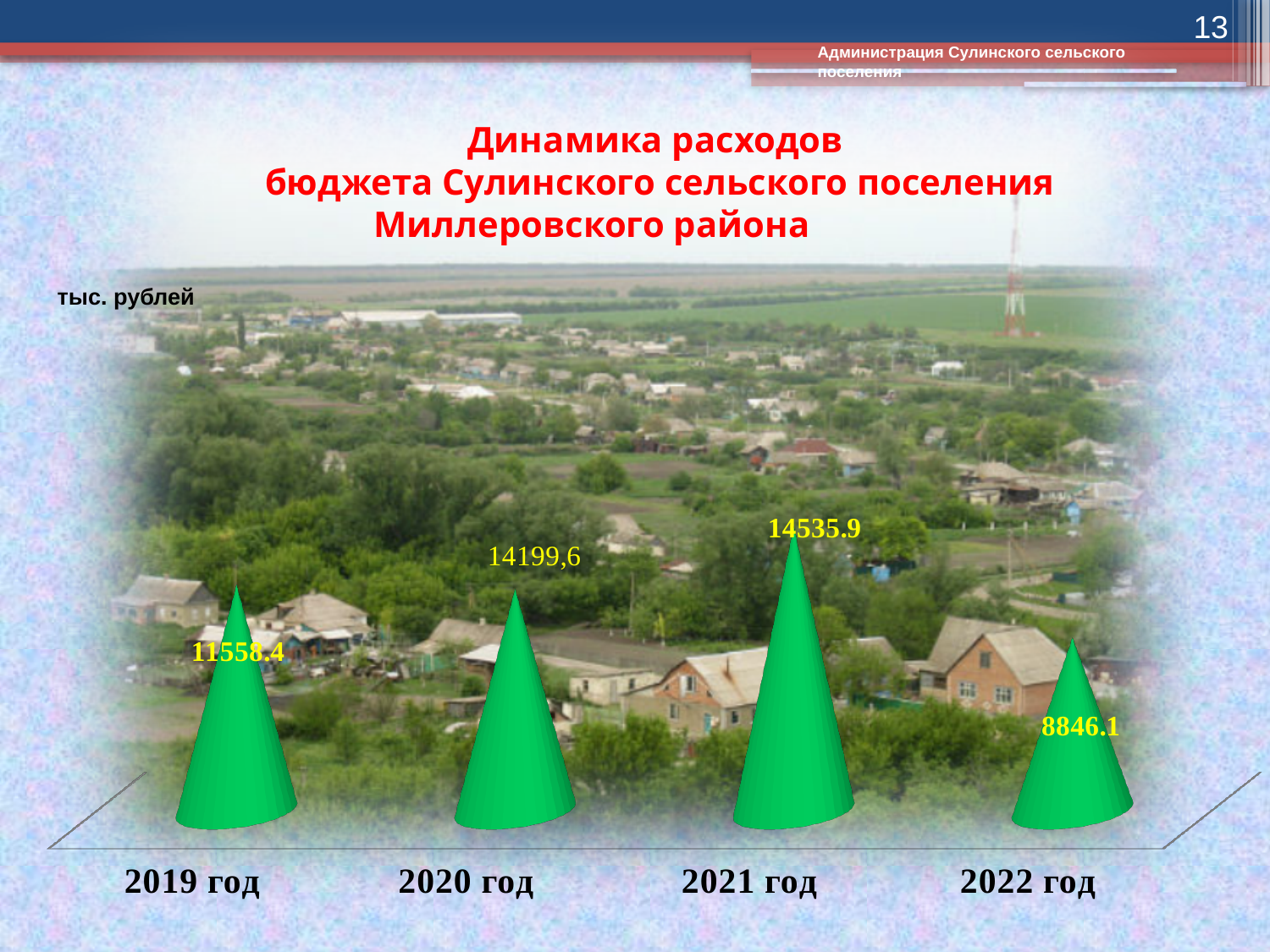
Which year has the lowest expenditure? 2022 год What is the value for 2020 год? 14199,6 What unit of measurement is indicated for the chart? тыс. рублей Which is larger, the value for 2020 год or 2021 год? 2021 год What is the difference between the values for 2021 год and 2019 год? 2977.5 What is the value for 2019 год? 11558.4 What is the difference between the values for 2019 год and 2022 год? 2712.3 What is the value for 2022 год? 8846.1 Which year has the highest expenditure? 2021 год Do the values rise or fall from 2021 год to 2022 год? fall What is the value for 2021 год? 14535.9 How many years are shown on the chart? 4